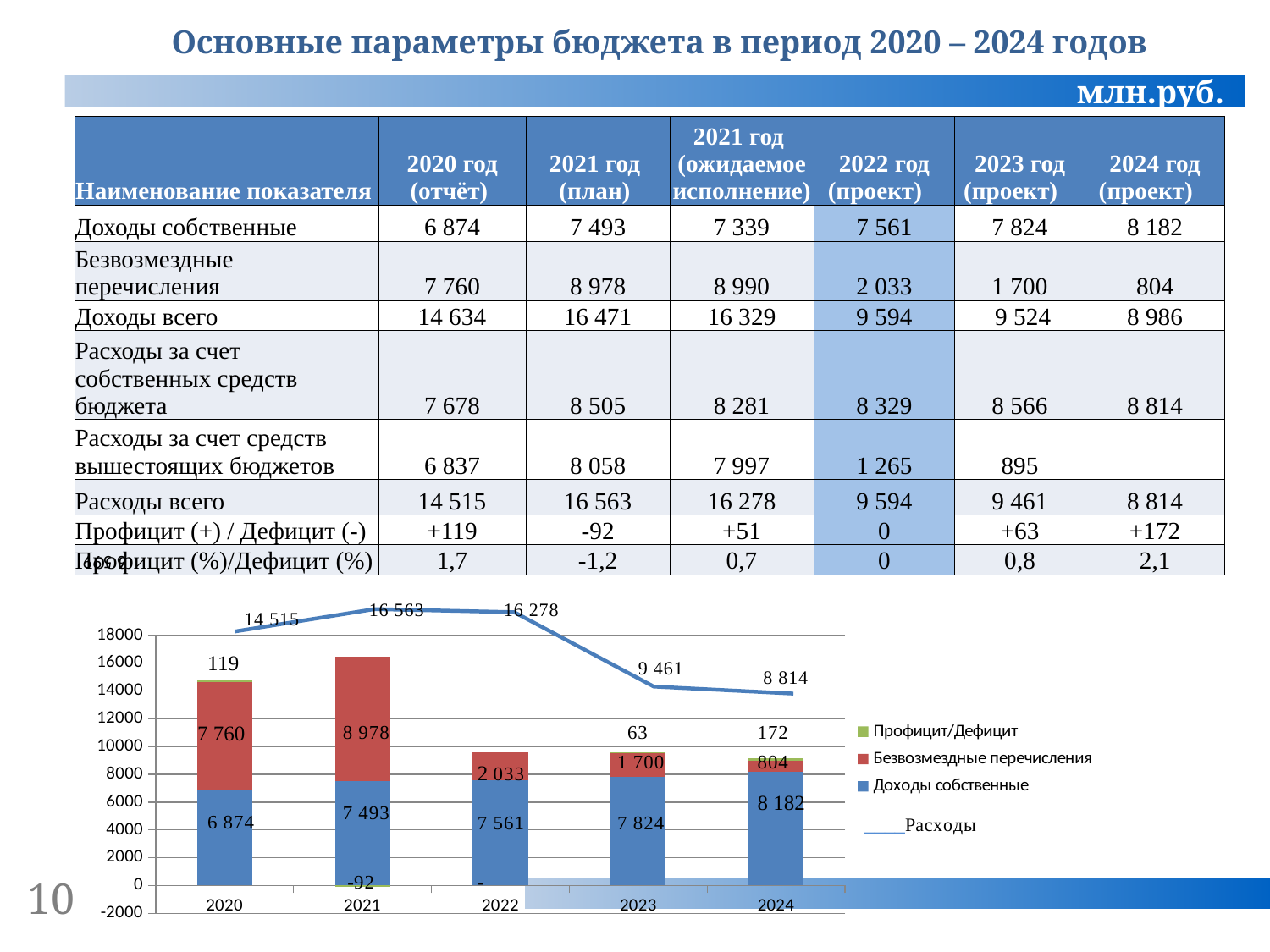
Which is larger in the chart: the Расходы value for 2021 or for 2022? 2021 What is the value of Доходы собственные for 2022 in the chart? 7 561 What is the value of Профицит/Дефицит for 2021 in the chart? -92 How many years are shown on the x axis of the chart? 5 In which year is Безвозмездные перечисления lowest in the chart? 2024 What is the value of the Расходы line for 2023 in the chart? 9 461 How many series does the chart legend list? 4 Does the Расходы line rise or fall from 2022 to 2024 in the chart? fall What kind of chart is shown on the slide? bar chart with a line In which year is Безвозмездные перечисления highest in the chart? 2021 What is the value of Безвозмездные перечисления for 2021 in the chart? 8 978 What is the difference between Доходы собственные in 2024 and in 2020 in the chart? 1 308